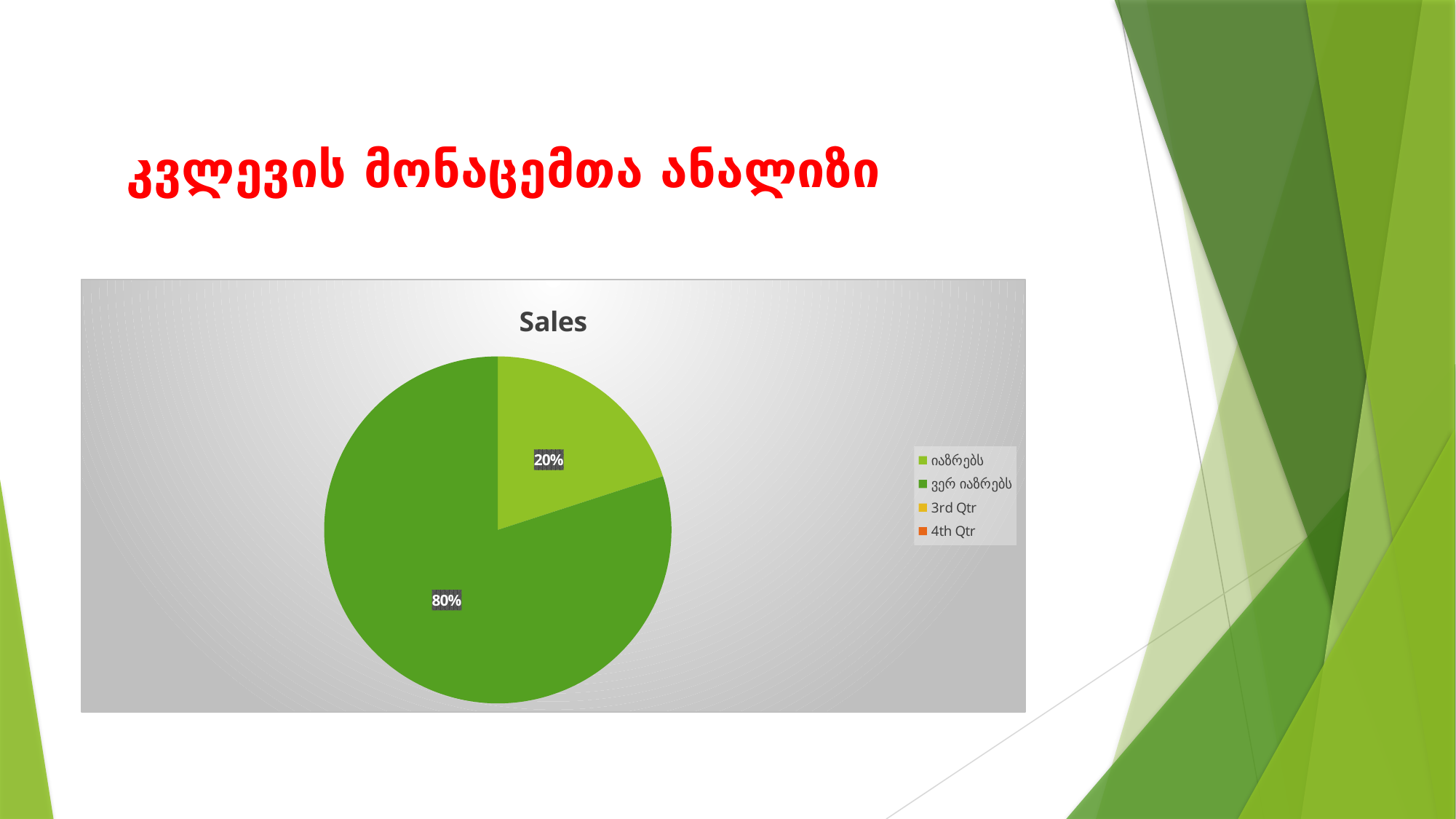
What percentage is shown for the ვერ იაზრებს slice? 80% What is the difference in percentage points between the ვერ იაზრებს slice and the იაზრებს slice? 60 Which slice of the pie is the largest? ვერ იაზრებს How many entries does the legend list? 4 What percentage is shown for the იაზრებს slice? 20% How many slices with data labels are visible in the pie? 2 Which is larger, the იაზრებს slice or the ვერ იაზრებს slice? ვერ იაზრებს What share of the pie does the ვერ იაზრებს slice take? 80% Which of the two labelled slices is the smallest? იაზრებს What colour is the ვერ იაზრებს slice? dark green What kind of chart is shown on the slide? pie chart What is the title of the chart? Sales